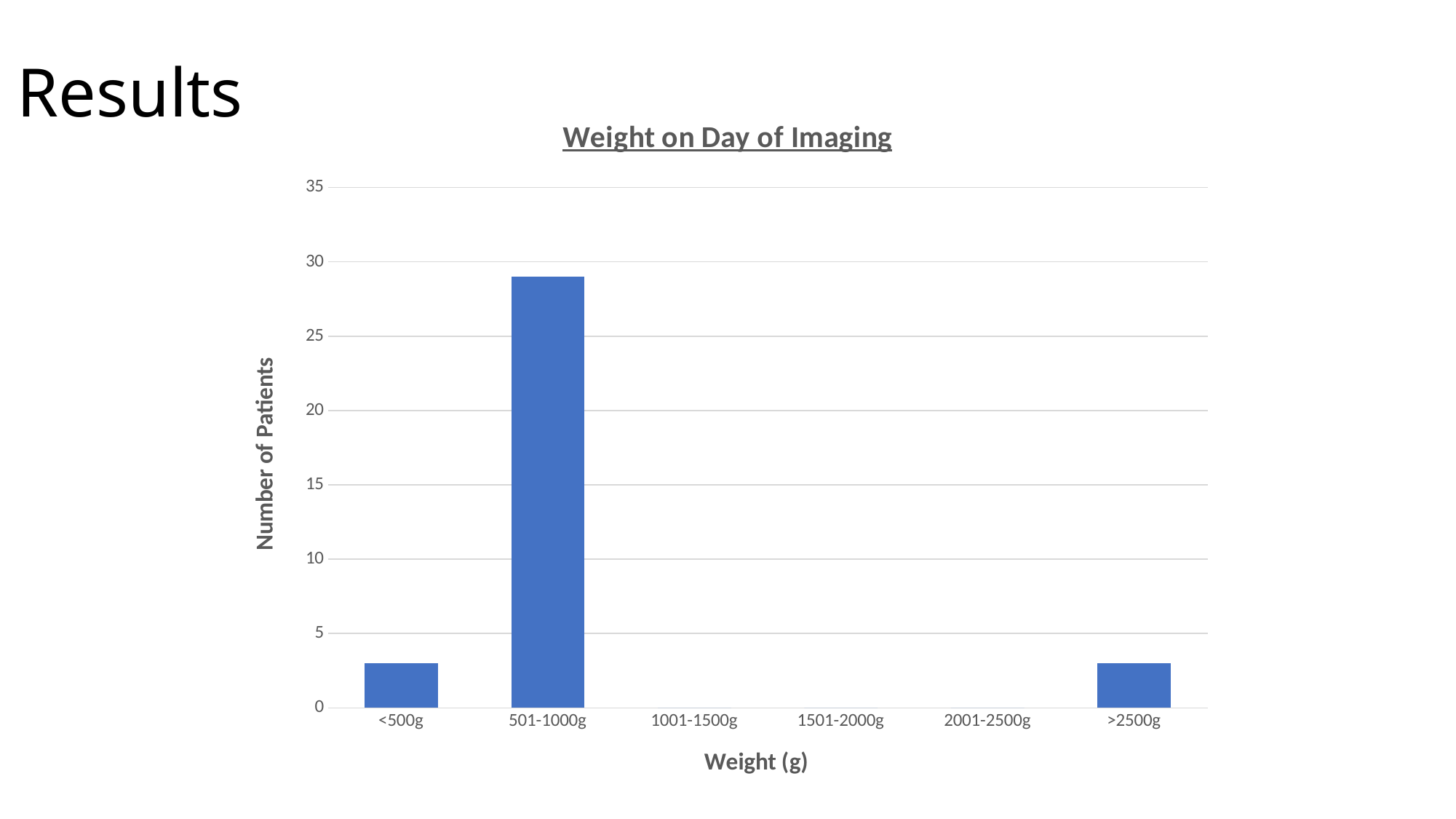
Is the number of patients for 501-1000g greater or less than 30? less Which has more patients, 501-1000g or <500g? 501-1000g How many patients are in the 1501-2000g category? 0 Is the number of patients for >2500g greater or less than 5? less What is the title of the chart? Weight on Day of Imaging How many weight categories are shown on the x axis? 6 Which has more patients, 501-1000g or >2500g? 501-1000g Is the number of patients for 501-1000g greater or less than 25? greater What type of chart is shown on the slide? Bar chart What is the label of the y axis? Number of Patients Which weight category has the highest number of patients? 501-1000g